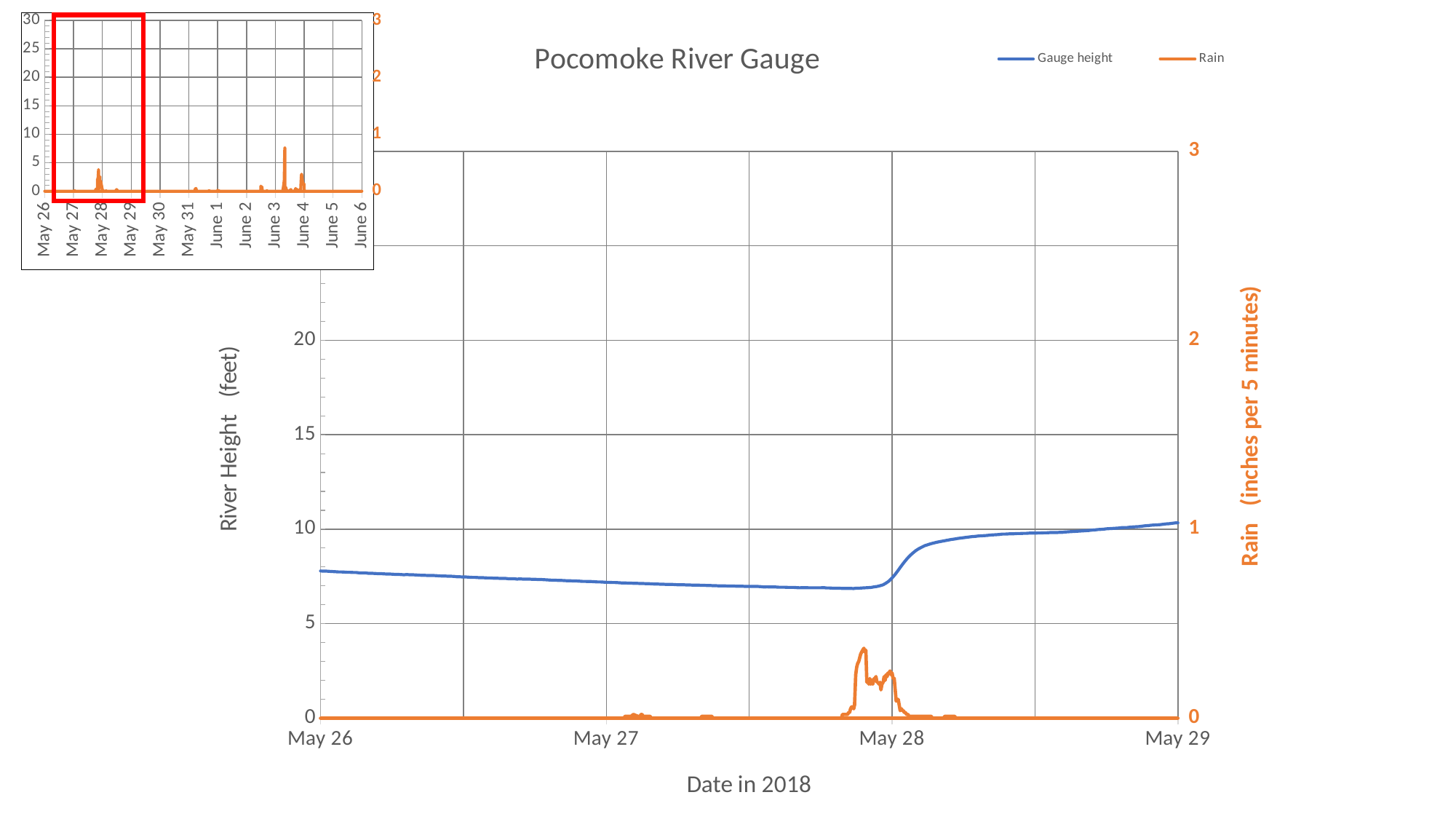
What is the title of the main chart on the slide? Pocomoke River Gauge In the Pocomoke River Gauge chart, does the Gauge height rise or fall between May 28 and May 29? rise In the Pocomoke River Gauge chart, does the Gauge height rise or fall between May 26 and May 27? fall In the Pocomoke River Gauge chart, is the Gauge height value on May 27 greater or less than 10? less In the Pocomoke River Gauge chart, which series is drawn in orange? Rain In the Pocomoke River Gauge chart, is the Gauge height value on May 26 greater or less than 5? greater How many date labels are shown on the x axis of the small inset chart in the top-left corner? 12 How many date labels are shown on the x axis of the main Pocomoke River Gauge chart? 4 In the Pocomoke River Gauge chart, is the peak Rain value near May 28 greater or less than 1 inch per 5 minutes? less How many series does the legend of the Pocomoke River Gauge chart list? 2 What kind of chart is the main Pocomoke River Gauge chart? Line chart